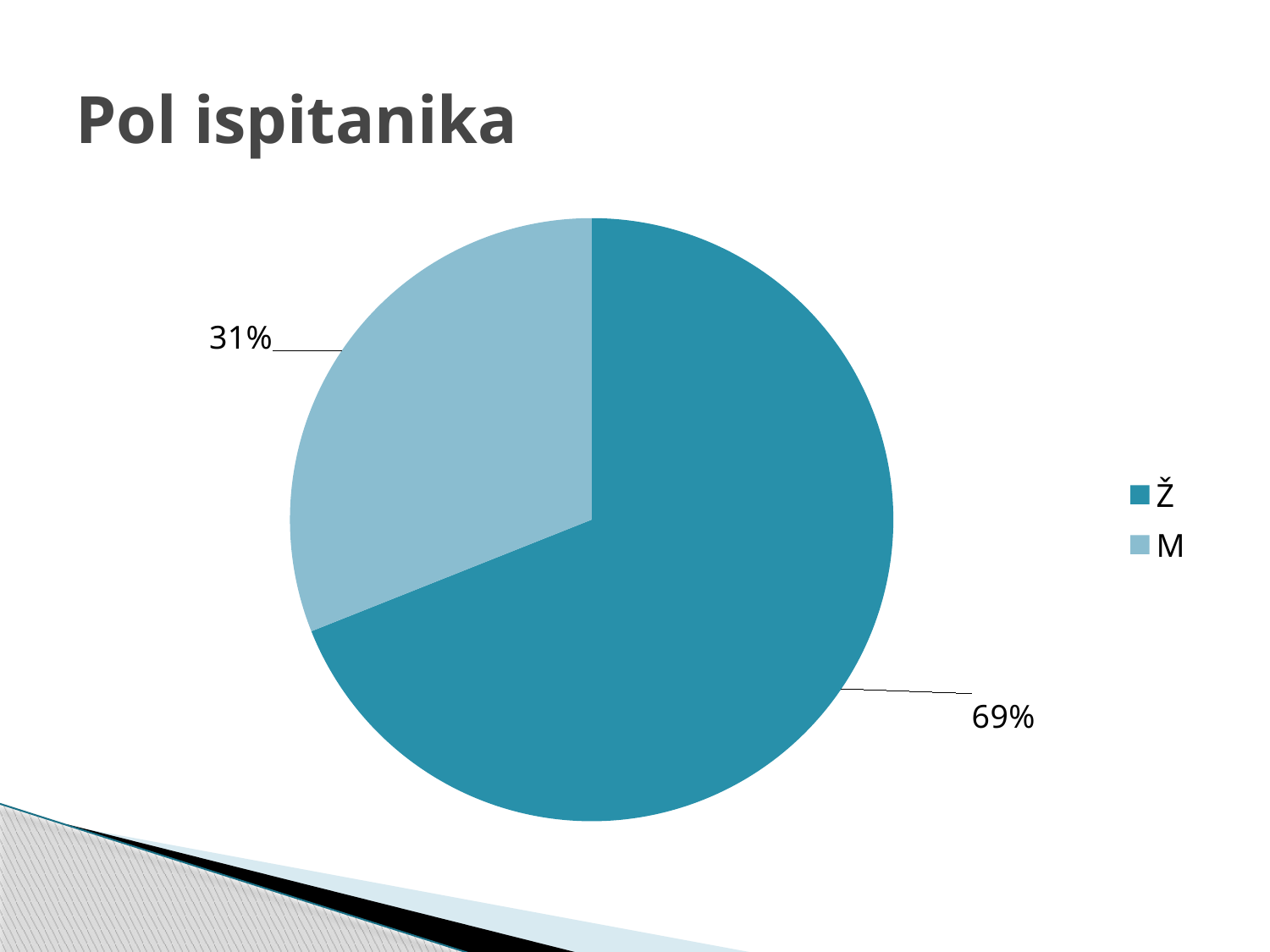
Which slice is larger, Ž or M? Ž How many entries does the legend list? 2 What is the difference in percentage points between the Ž and M slices? 38 Which category has the smallest slice of the pie? M What is the title of the slide containing the chart? Pol ispitanika Which category has the largest slice of the pie? Ž Which legend entry is shown in the lighter blue colour? M What kind of chart is shown on the slide? pie chart What share of the pie does Ž represent? 69% What share of the pie does M represent? 31% How many slices does the pie chart have? 2